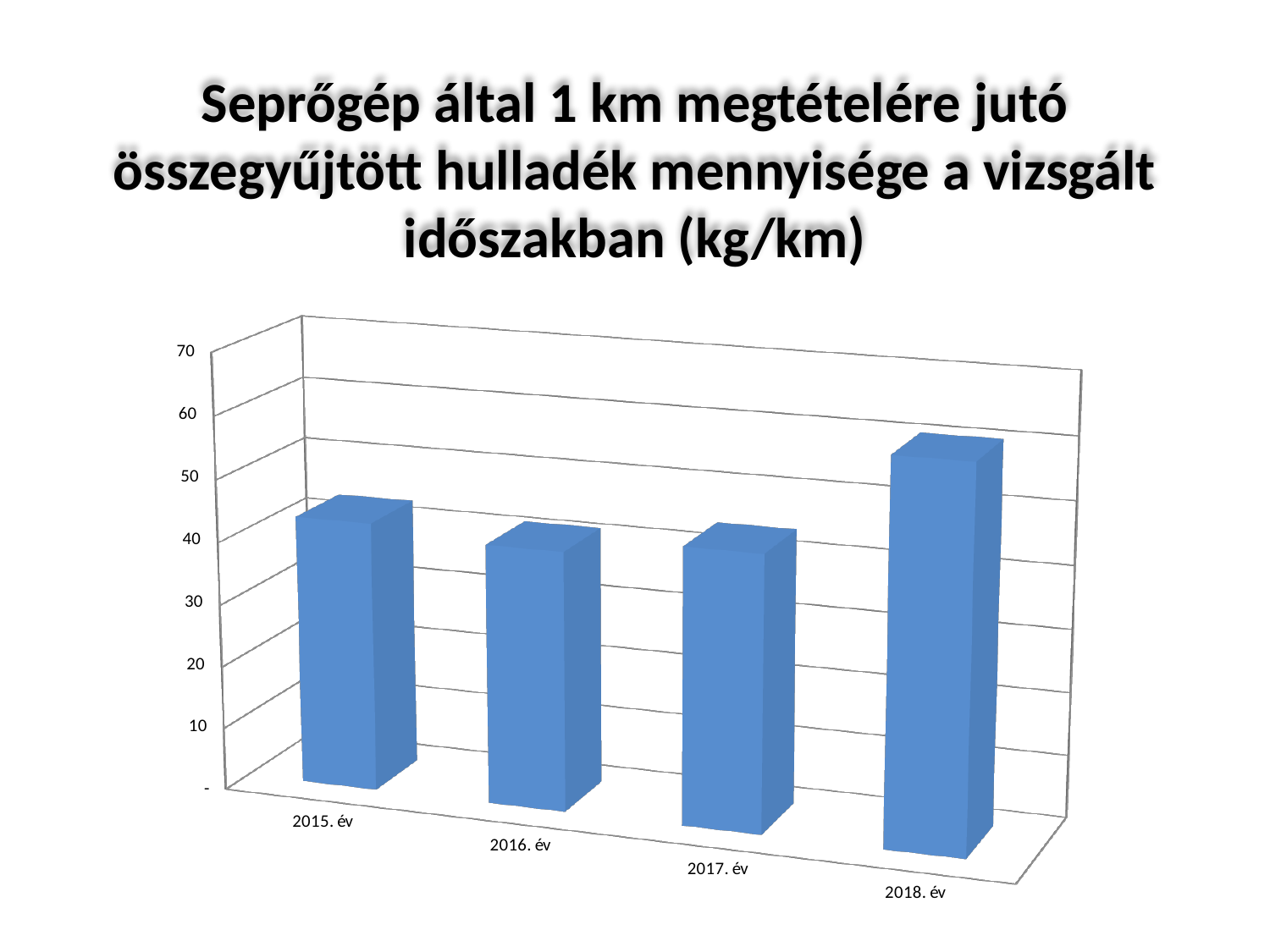
What unit is given in the chart title? kg/km Which is larger, the value for 2017. év or the value for 2018. év? 2018. év Which is larger, the value for 2018. év or the value for 2015. év? 2018. év Is the value for 2017. év greater or less than 50? less Which year has the highest value? 2018. év Is the value for 2015. év greater or less than 30? greater What kind of chart is shown on the slide? bar chart How many years (categories) are shown on the x axis? 4 Is the value for 2015. év greater or less than 50? less What is the highest tick value shown on the vertical axis? 70